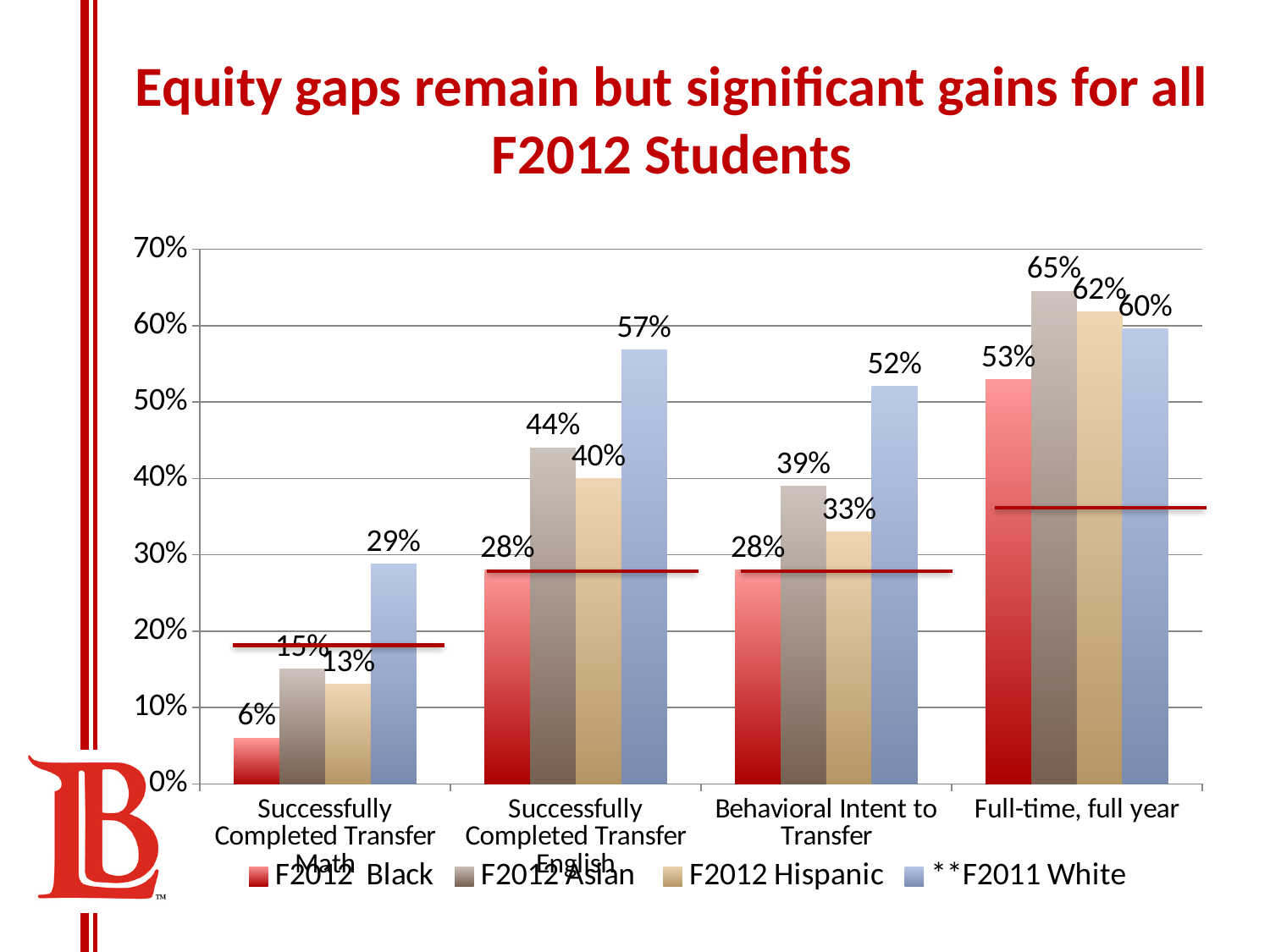
Which is larger in the Behavioral Intent to Transfer category: F2012 Asian or F2012 Hispanic? F2012 Asian How many categories are shown on the x axis? 4 What is the value for F2012 Hispanic in the Successfully Completed Transfer English category? 40% What is the title of the slide? Equity gaps remain but significant gains for all F2012 Students Which series has the highest value in the Successfully Completed Transfer English category? F2011 White What kind of chart is shown on the slide? Bar chart How many series does the legend list? 4 What is the value for F2012 Asian in the Full-time, full year category? 65% What is the difference between the F2011 White and F2012 Black values in the Successfully Completed Transfer English category? 29% What is the value for F2011 White in the Behavioral Intent to Transfer category? 52% Which series has the lowest value in the Full-time, full year category? F2012 Black What is the value for F2012 Black in the Successfully Completed Transfer Math category? 6%